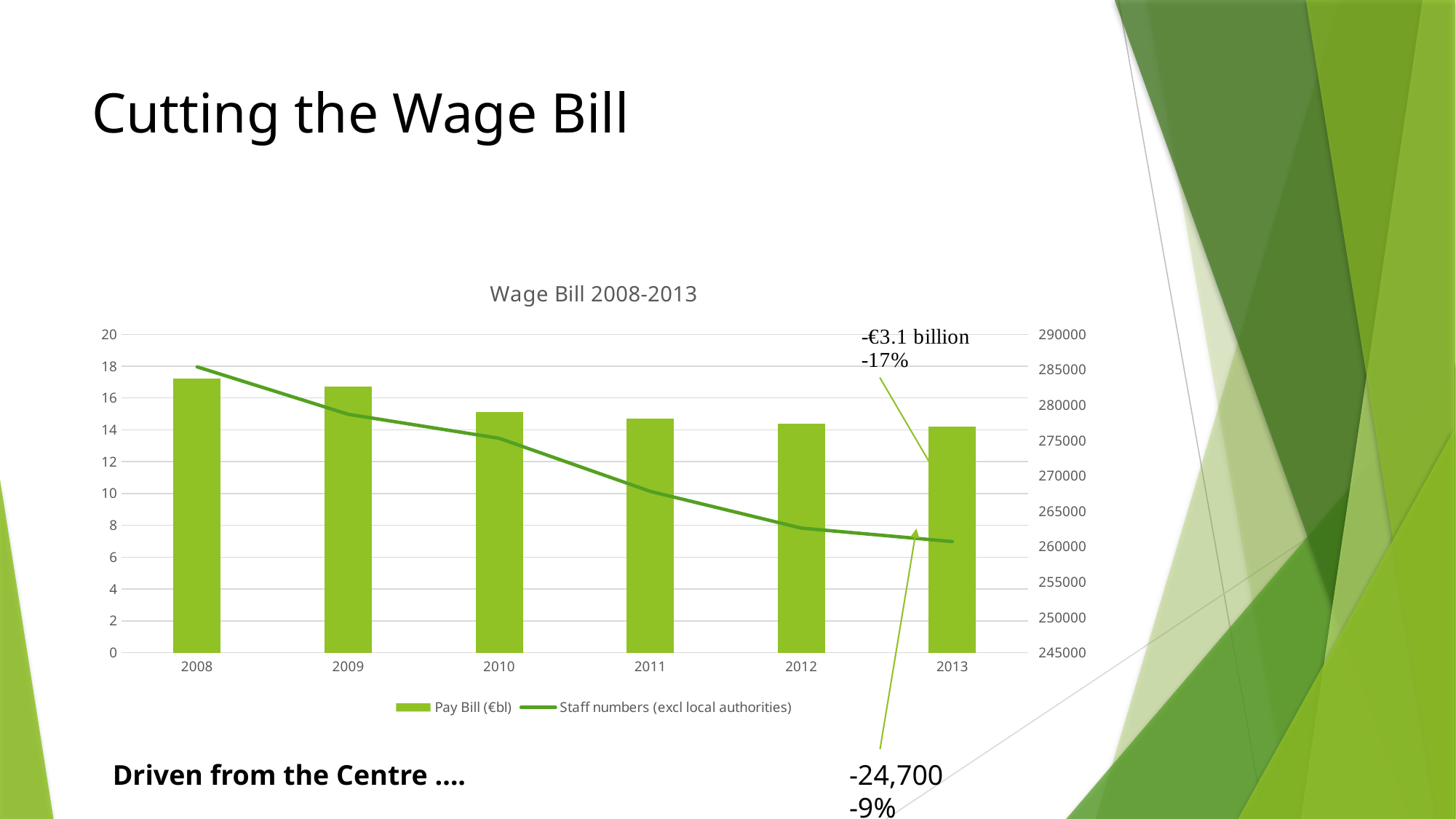
Do the Staff numbers rise or fall from 2008 to 2013? Fall What kind of chart is shown on the slide? A combined bar and line chart Which year has the highest Pay Bill bar? 2008 What is the title of the chart? Wage Bill 2008-2013 Is the Pay Bill value for 2013 greater or less than 16? less How many series does the legend list? 2 Do the Pay Bill bars rise or fall from 2008 to 2013? Fall Is the Staff numbers value for 2008 greater or less than 280000? greater Which series is plotted as a line in the chart? Staff numbers (excl local authorities) Which year has the larger Pay Bill bar, 2008 or 2010? 2008 Is the Pay Bill value for 2008 greater or less than 16? greater How many years are shown on the x axis of the chart? 6